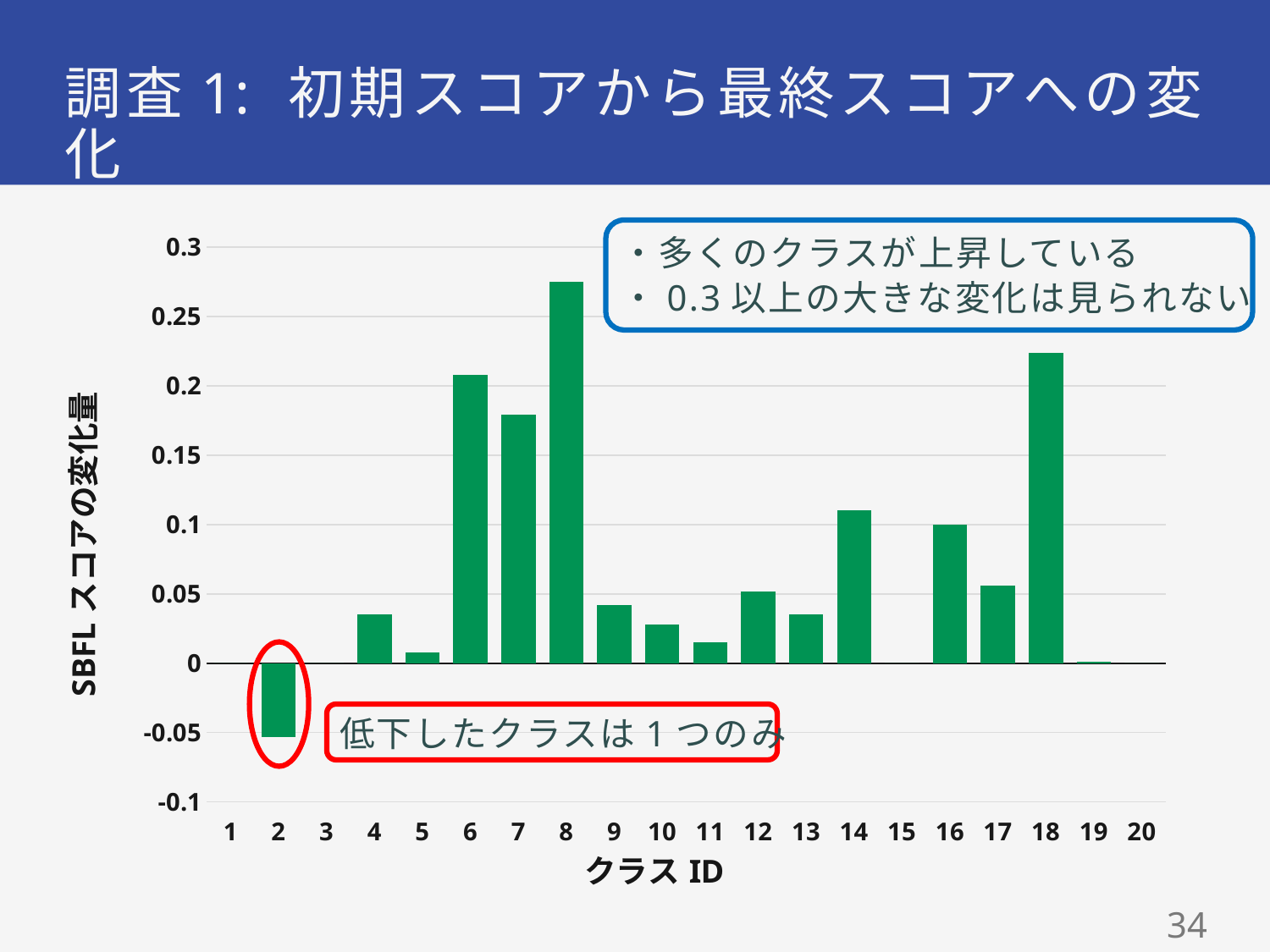
Which has the larger SBFL score change, class ID 14 or class ID 17? 14 How many class IDs are listed along the x axis? 20 Which class ID has the highest SBFL score change? 8 Is the value for class ID 8 greater or less than 0.25? greater Is the value for class ID 7 greater or less than 0.2? less Is the value for class ID 2 greater or less than 0? less Which has the larger SBFL score change, class ID 6 or class ID 7? 6 What kind of chart is shown on the slide? bar chart What is the label of the y axis? SBFL スコアの変化量 Which class ID has the lowest SBFL score change? 2